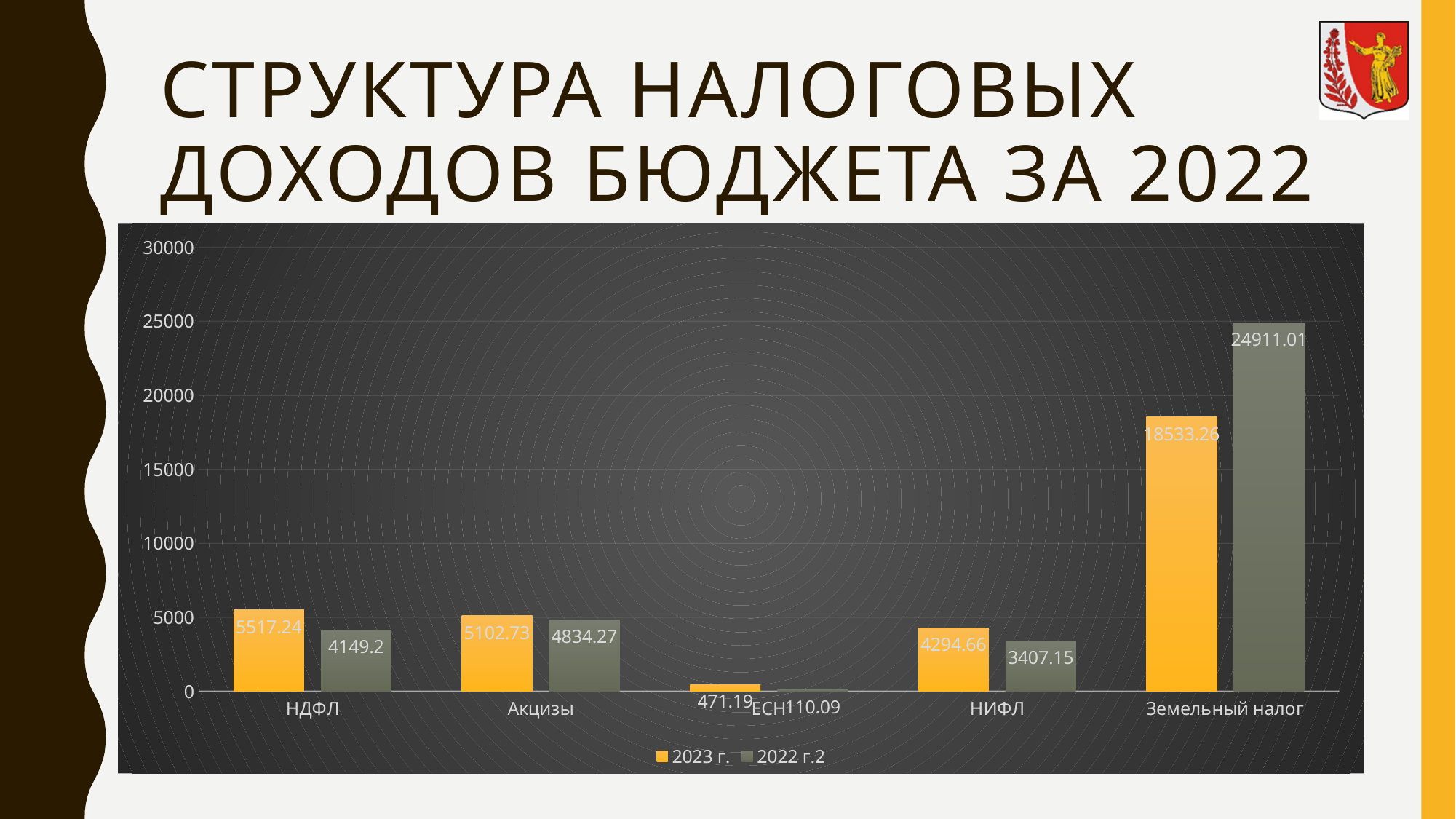
Which category has the highest value in the 2023 г. series? Земельный налог What is the value for Земельный налог in the 2022 г.2 series? 24911.01 What kind of chart is shown on the slide? bar chart Is the 2023 г. value for Земельный налог greater or less than 20000? less What is the value for ЕСН in the 2023 г. series? 471.19 What is the difference between the 2022 г.2 and 2023 г. values for Земельный налог? 6377.75 Which category has the lowest value in the 2022 г.2 series? ЕСН What is the value for НДФЛ in the 2023 г. series? 5517.24 How many categories are shown on the x axis? 5 What is the value for Акцизы in the 2022 г.2 series? 4834.27 For НИФЛ, which series has the larger value, 2023 г. or 2022 г.2? 2023 г. How many series does the legend list? 2